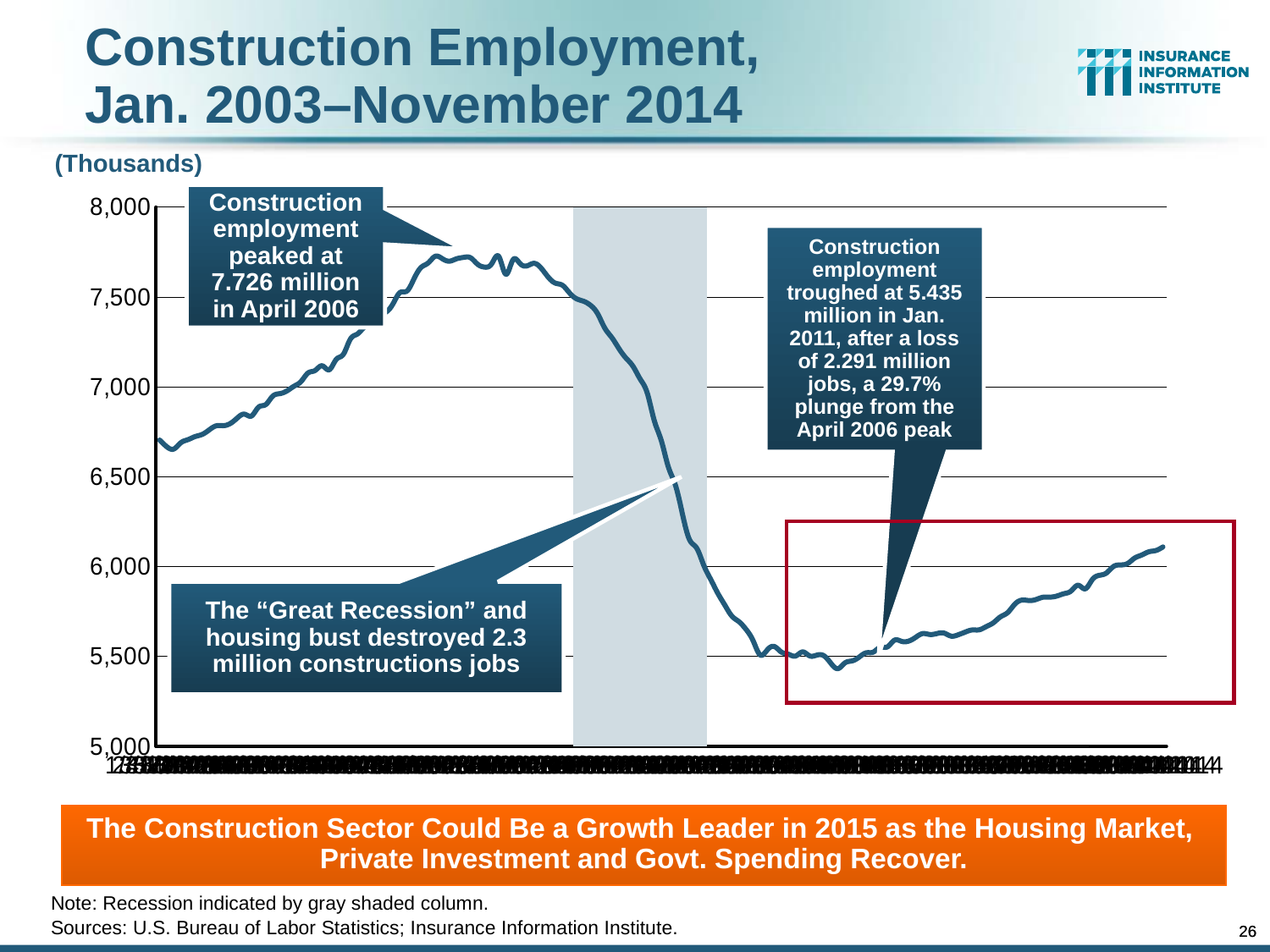
In which month and year did construction employment peak? April 2006 At what level did construction employment trough, according to the callout on the chart? 5.435 million Did construction employment rise or fall between April 2006 and January 2011? Fall At what level did construction employment peak, according to the callout on the chart? 7.726 million By what percentage did construction employment plunge from the April 2006 peak to the Jan. 2011 trough? 29.7% What kind of chart is shown on the slide? Line chart Is the construction employment value at the start of the series (January 2003) greater or less than 7,000? less Did construction employment rise or fall between January 2011 and November 2014? Rise What does the gray shaded column on the chart indicate? Recession In which month and year did construction employment trough? Jan. 2011 Is the construction employment value at the end of the series (November 2014) greater or less than 6,500? less How many jobs were lost between the April 2006 peak and the Jan. 2011 trough? 2.291 million